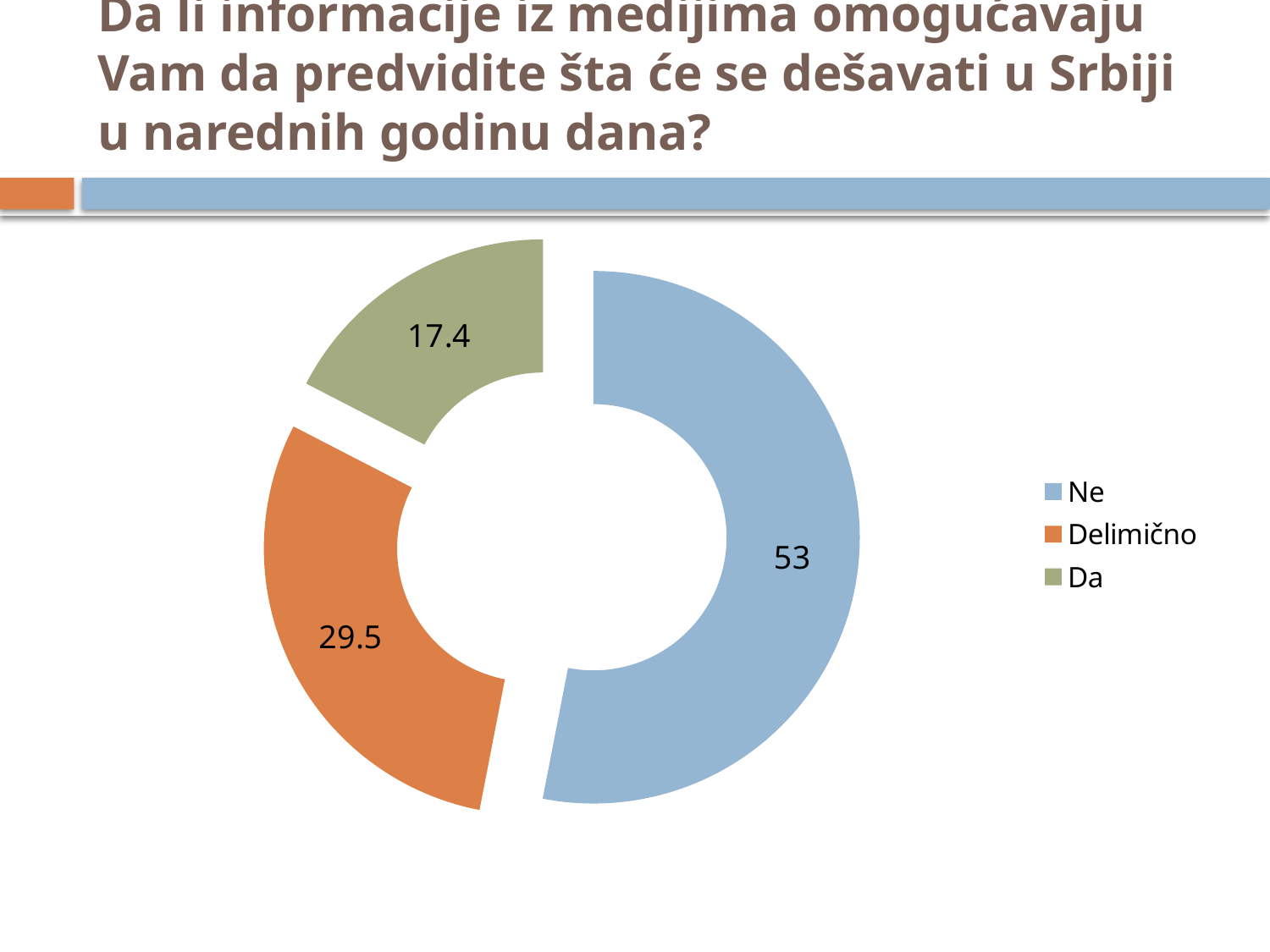
Which category has the smallest slice? Da What colour is the "Delimično" slice? Orange What value is shown for the "Ne" slice? 53 What is the difference between the values for "Ne" and "Delimično"? 23.5 What kind of chart is shown on the slide? Doughnut (pie) chart Which legend entry is listed first? Ne What is the difference between the values for "Delimično" and "Da"? 12.1 What value is shown for the "Da" slice? 17.4 What value is shown for the "Delimično" slice? 29.5 Which is larger, the value for "Delimično" or the value for "Da"? Delimično How many categories does the chart show? 3 Which category has the largest slice? Ne